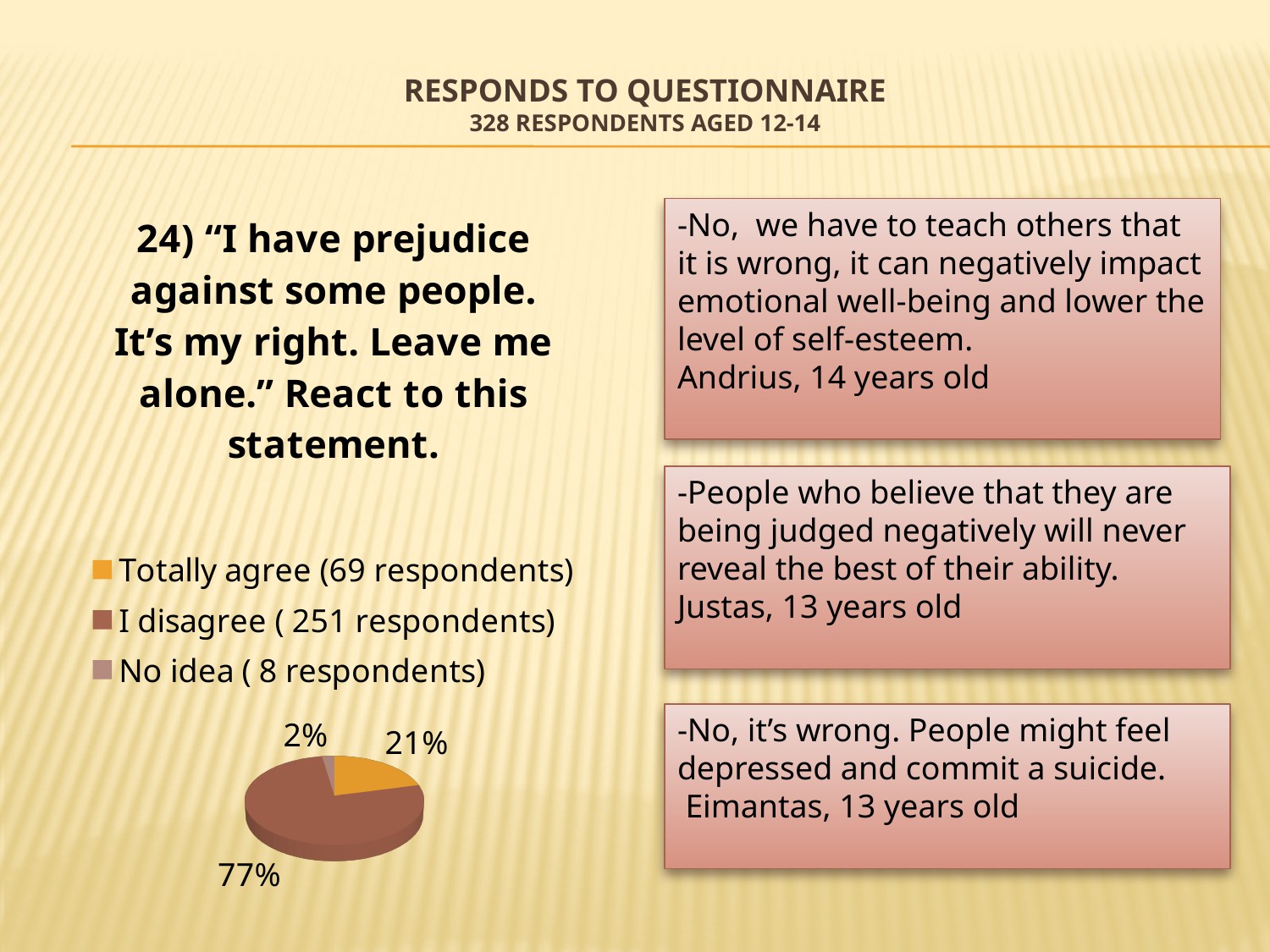
What is the difference in percentage points between the "I disagree" slice and the "Totally agree" slice? 56 How many categories does the pie chart show? 3 What percentage of the pie does "I disagree" represent? 77% Which slice is larger, "Totally agree" or "No idea"? Totally agree How many respondents chose "Totally agree" according to the legend? 69 respondents What kind of chart is shown on the slide? pie chart What percentage of the pie does "No idea" represent? 2% Which category has the smallest slice of the pie? No idea Which category has the largest slice of the pie? I disagree What percentage of the pie does "Totally agree" represent? 21% How many respondents chose "I disagree" according to the legend? 251 respondents What colour is the "Totally agree" slice in the pie chart? orange